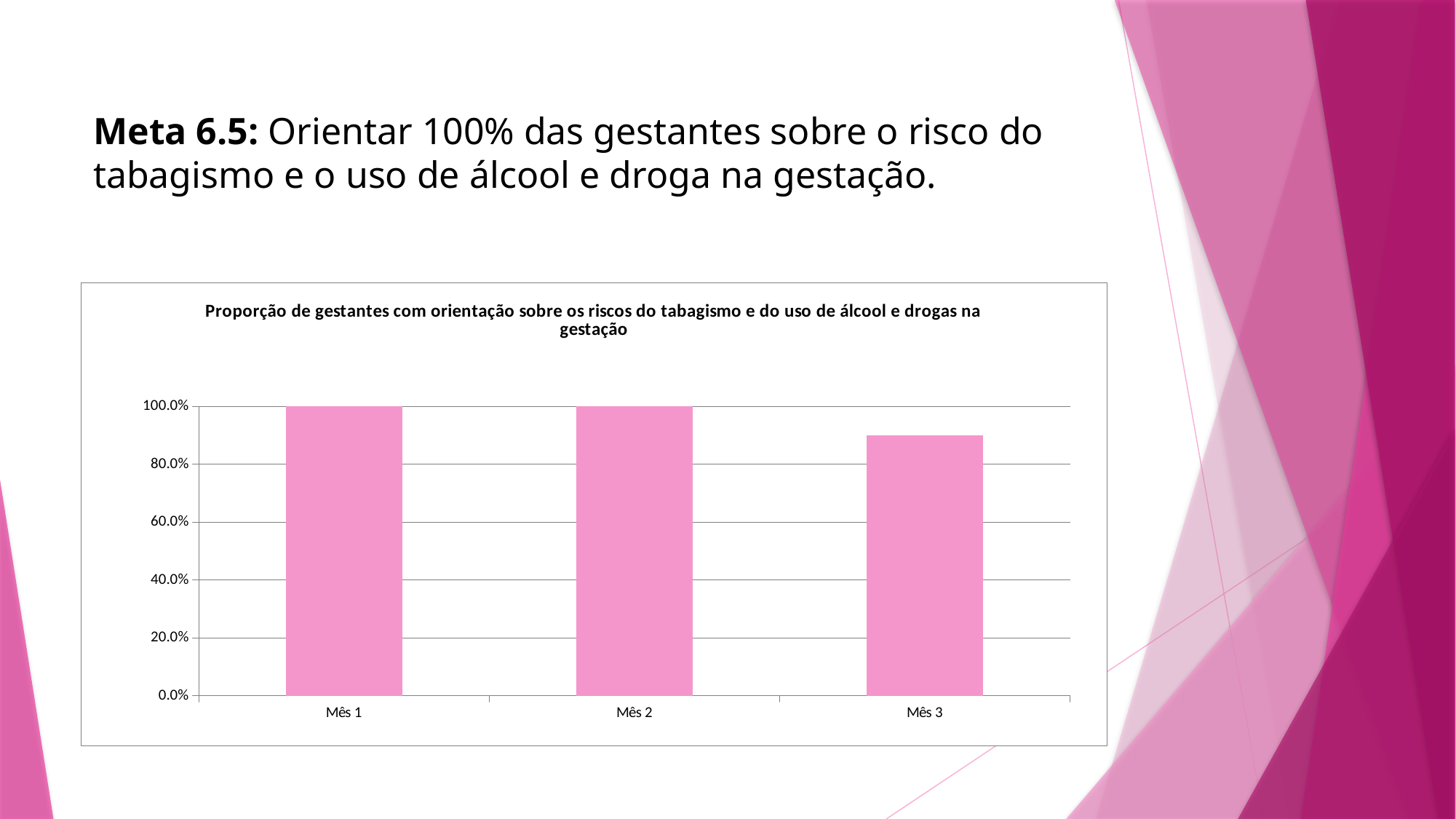
Is the value for Mês 3 greater or less than 100.0%? less Is the value for Mês 3 greater or less than 80.0%? greater Which month has the lowest value? Mês 3 Does the value rise or fall from Mês 2 to Mês 3? fall What is the difference between the values for Mês 1 and Mês 2? 0.0% What is the value for Mês 2? 100.0% What kind of chart is shown on the slide? bar chart What is the value for Mês 1? 100.0% Which is larger, the value for Mês 1 or the value for Mês 3? Mês 1 Which is larger, the value for Mês 2 or the value for Mês 3? Mês 2 How many months (categories) are shown on the x axis? 3 What is the title of the chart? Proporção de gestantes com orientação sobre os riscos do tabagismo e do uso de álcool e drogas na gestação